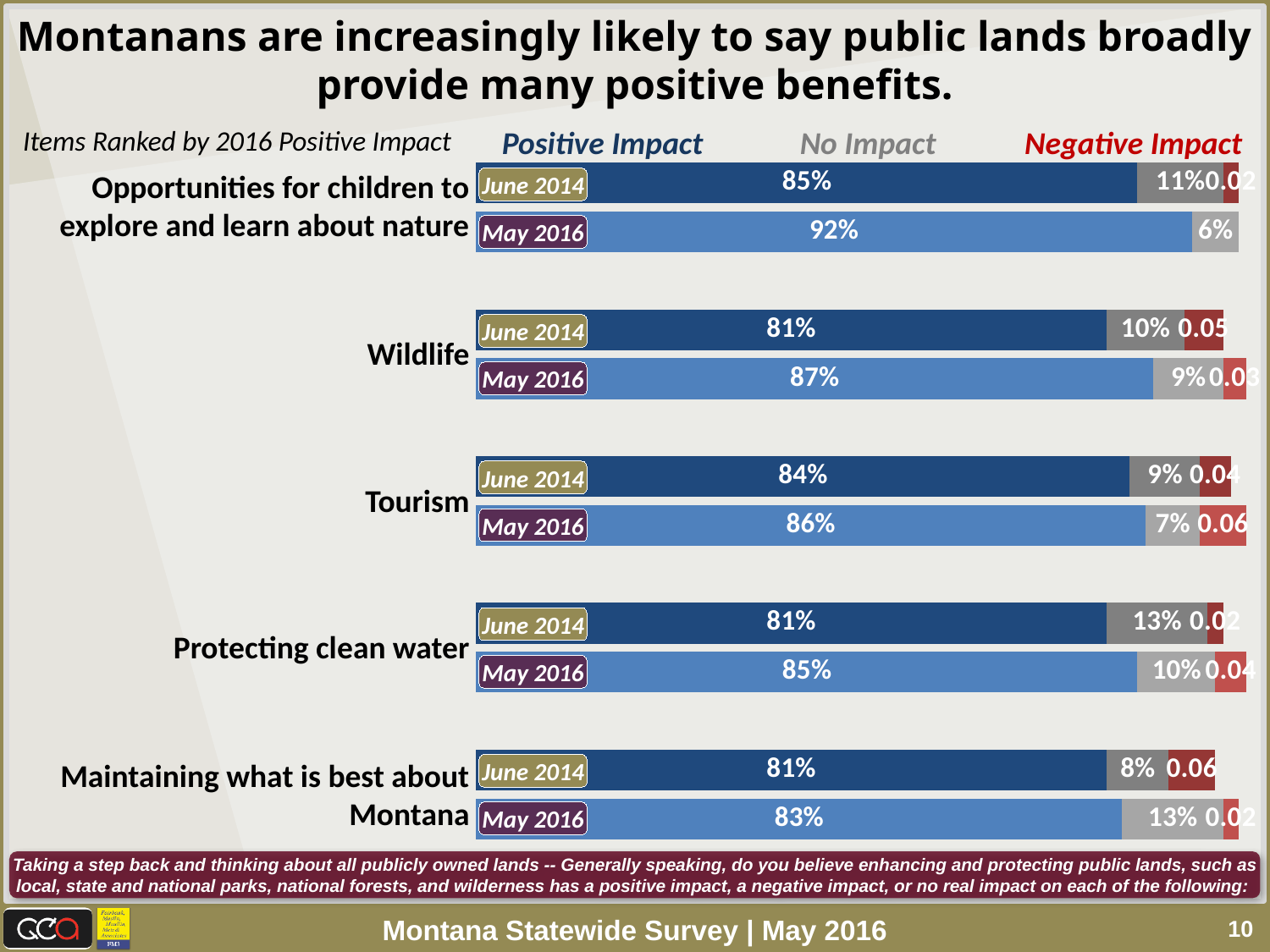
What type of chart is shown on the slide? Stacked bar chart What is the No Impact percentage for Maintaining what is best about Montana in May 2016? 13% What percentage of Montanans said public lands have a positive impact on opportunities for children to explore and learn about nature in May 2016? 92% Which item had the highest Positive Impact percentage in May 2016? Opportunities for children to explore and learn about nature By how many percentage points did the Positive Impact share for Wildlife increase from June 2014 to May 2016? 6 Which is larger: the May 2016 Positive Impact percentage for Protecting clean water or for Tourism? Tourism What was the Positive Impact percentage for Tourism in May 2016? 86% What was the No Impact percentage for Protecting clean water in June 2014? 13% What was the Positive Impact percentage for Wildlife in June 2014? 81% Which item had the lowest Positive Impact percentage in May 2016? Maintaining what is best about Montana How many items are ranked in the chart? 5 How many response categories does the chart legend list? 3